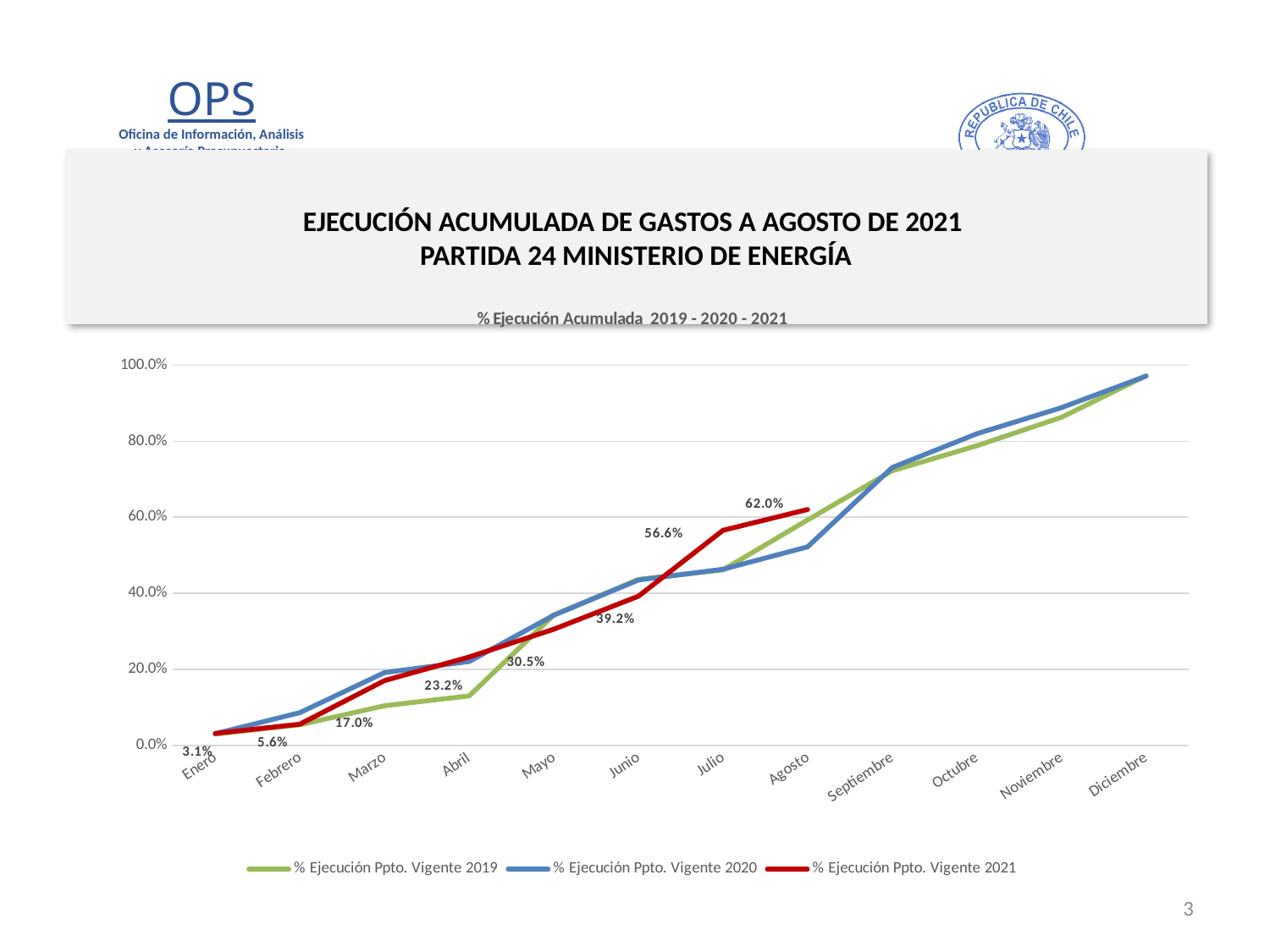
What kind of chart is shown on the slide? Line chart What is the value for % Ejecución Ppto. Vigente 2021 in Marzo? 17.0% In Agosto, which series has the larger value: % Ejecución Ppto. Vigente 2021 or % Ejecución Ppto. Vigente 2020? % Ejecución Ppto. Vigente 2021 In which month is the % Ejecución Ppto. Vigente 2021 value lowest? Enero What is the value for % Ejecución Ppto. Vigente 2021 in Agosto? 62.0% How many series does the legend list? 3 What is the value for % Ejecución Ppto. Vigente 2021 in Enero? 3.1% What is the value for % Ejecución Ppto. Vigente 2021 in Junio? 39.2% What is the difference between the 2021 values for Agosto and Enero? 58.9% In which month does the % Ejecución Ppto. Vigente 2021 series reach its highest labelled value? Agosto Is the value for % Ejecución Ppto. Vigente 2020 in Diciembre greater or less than 80.0%? greater What is the difference between the 2021 values for Julio and Junio? 17.4%